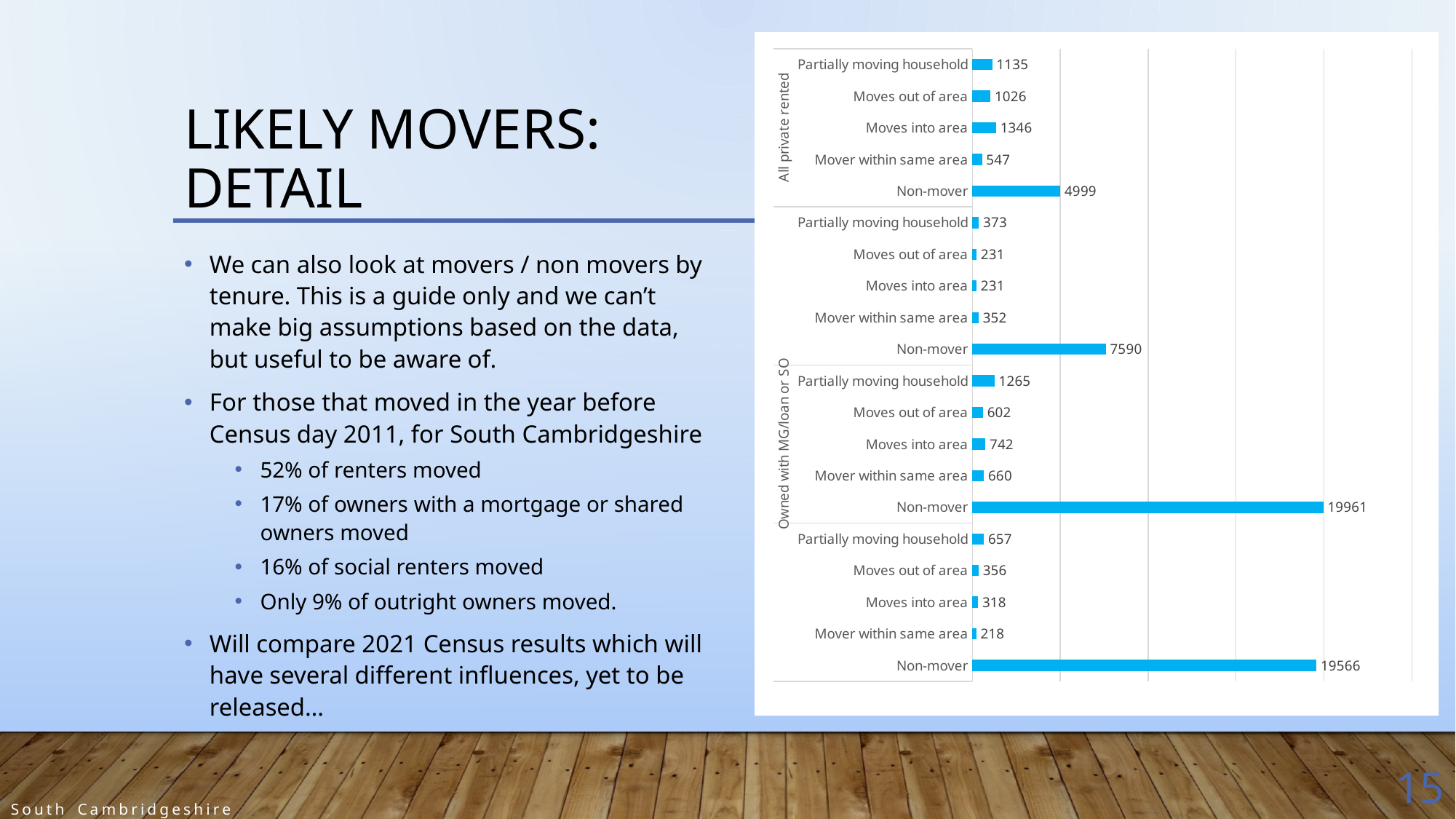
In the chart, what is the value for Partially moving household in the Owned with MG/loan or SO group? 1265 In the All private rented group, what is the difference between Moves into area and Moves out of area? 320 In the All private rented group, which is larger: Partially moving household or Moves out of area? Partially moving household In the chart, what is the value for Mover within same area in the All private rented group? 547 What is the smallest value labelled on the chart? 218 What type of chart is shown on the slide? Bar chart In the chart, what is the value for Non-mover in the All private rented group? 4999 Which bar has the highest value in the chart? Non-mover in Owned with MG/loan or SO (19961) In the chart, what is the value for Moves into area in the All private rented group? 1346 In the chart, what is the value for Non-mover in the Owned with MG/loan or SO group? 19961 How many bars are plotted in the chart? 20 In the Owned with MG/loan or SO group, what is the difference between Moves into area and Moves out of area? 140